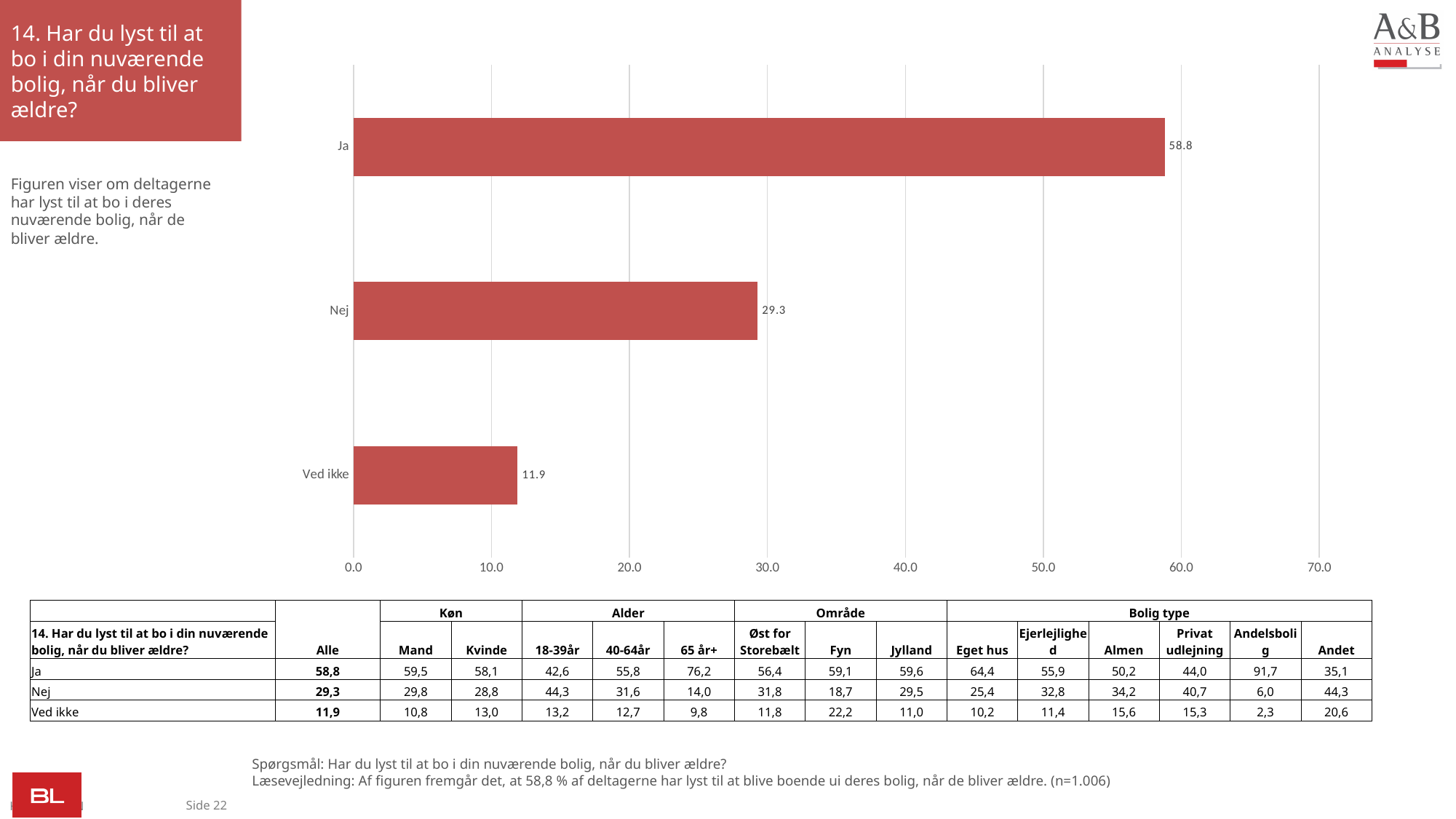
What is the highest tick value shown on the horizontal axis of the chart? 70.0 How many categories are shown in the chart? 3 Which is larger, the value for "Nej" or the value for "Ved ikke"? Nej What is the difference between the values for "Nej" and "Ved ikke"? 17.4 What kind of chart is shown on the slide? bar chart What is the value for "Ja" in the chart? 58.8 Which category has the lowest value in the chart? Ved ikke What is the value for "Nej" in the chart? 29.3 Which category has the highest value in the chart? Ja What is the difference between the values for "Ja" and "Nej"? 29.5 Is the value for "Ja" greater or less than 50.0? greater What is the value for "Ved ikke" in the chart? 11.9